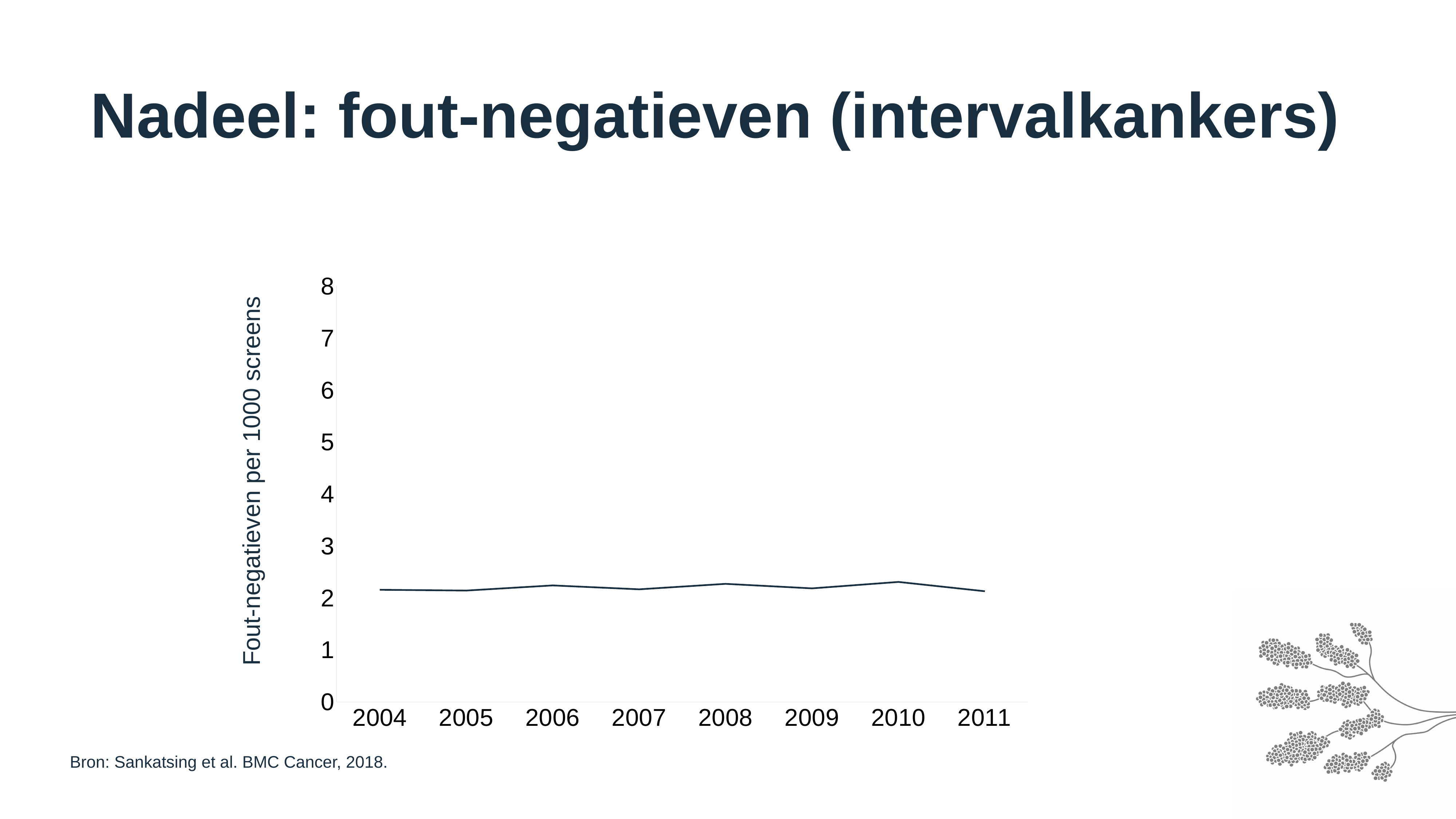
Is the value for 2010 greater or less than 1? greater What is the highest value shown on the y axis of the chart? 8 What is the last year shown on the x axis of the chart? 2011 Does the line rise sharply, fall sharply, or stay roughly flat from 2004 to 2011? stays roughly flat Is the value for 2011 greater or less than 1? greater Is the value for 2008 greater or less than 4? less What is the first year shown on the x axis of the chart? 2004 What kind of chart is shown on the slide? line chart How many years are plotted along the x axis of the chart? 8